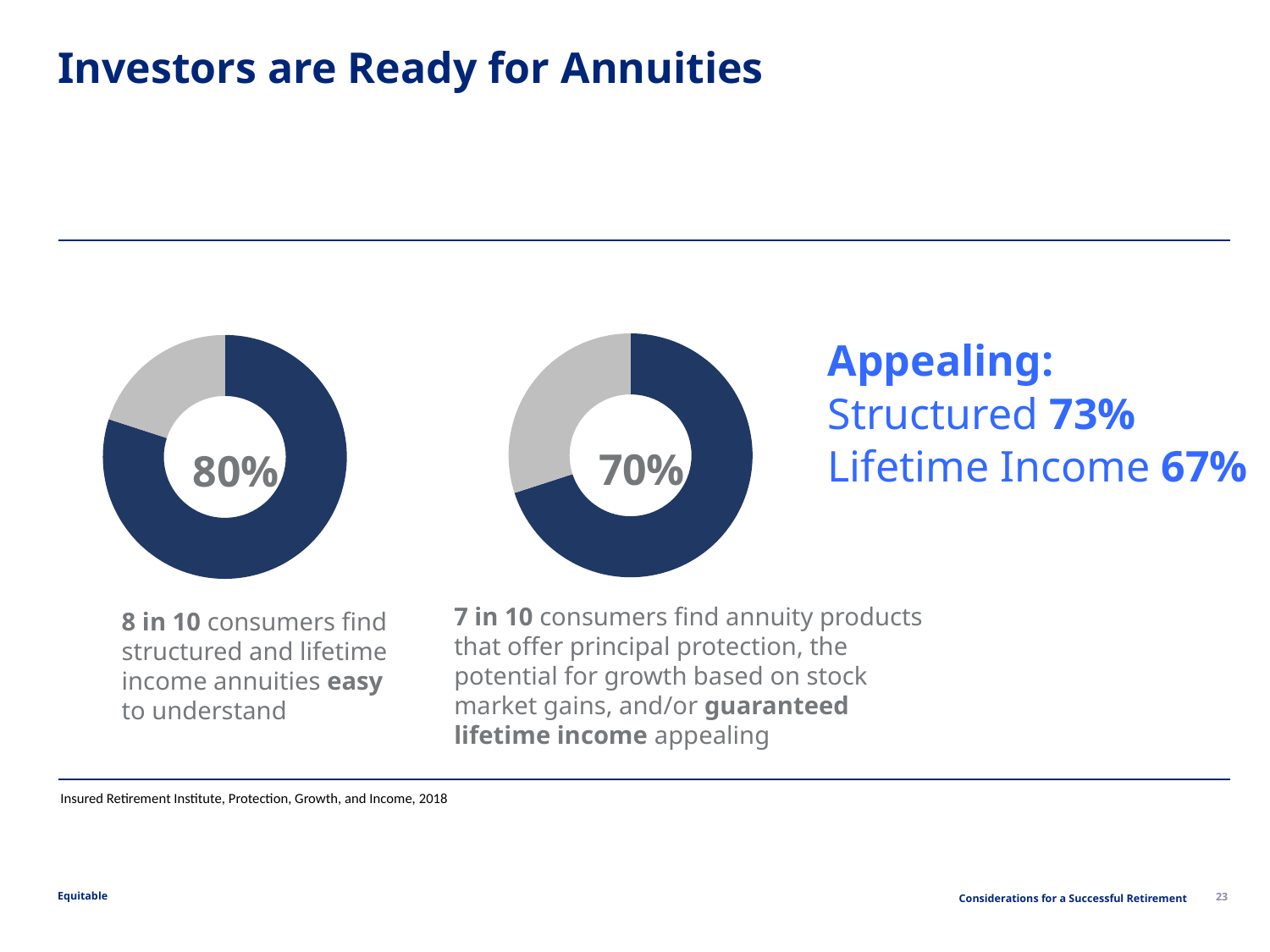
What value is shown in the centre of the right donut chart? 70% What kind of chart is the left chart on the slide? Donut (pie) chart Which chart shows the larger percentage, the left donut or the right donut? The left donut In the left donut chart, what share of the ring is filled by the dark blue segment? 80% In the right donut chart, what share of the ring is filled by the dark blue segment? 70% How many segments does the right donut chart have? 2 What colour is the larger segment in both donut charts? Dark blue What kind of chart is the right chart on the slide? Donut (pie) chart How many segments does the left donut chart have? 2 What is the difference between the percentage shown in the left donut chart and the percentage shown in the right donut chart? 10 percentage points Is the value shown in the right donut chart greater or less than 75%? less What value is shown in the centre of the left donut chart? 80%